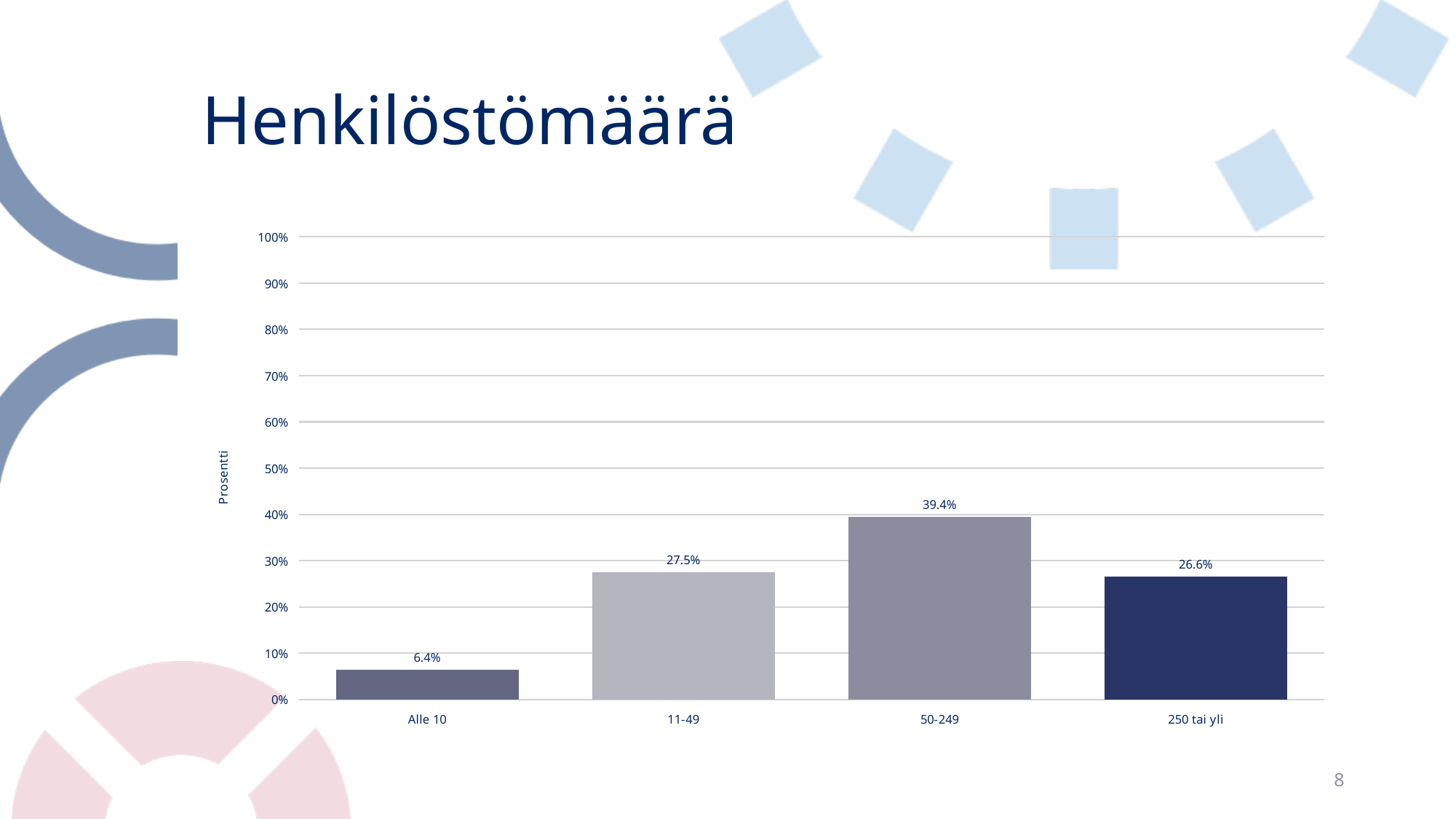
How many categories are shown on the x axis? 4 What is the value for the 'Alle 10' category? 6.4% Which is larger, the value for '11-49' or the value for '250 tai yli'? 11-49 What is the difference between the values for '250 tai yli' and 'Alle 10'? 20.2% What kind of chart is shown on the slide? Bar chart What is the value for the '250 tai yli' category? 26.6% What is the value for the '11-49' category? 27.5% Which category has the lowest value? Alle 10 What is the difference between the values for '50-249' and '11-49'? 11.9% Which category has the highest value? 50-249 What is the value for the '50-249' category? 39.4% What is the label of the y axis? Prosentti